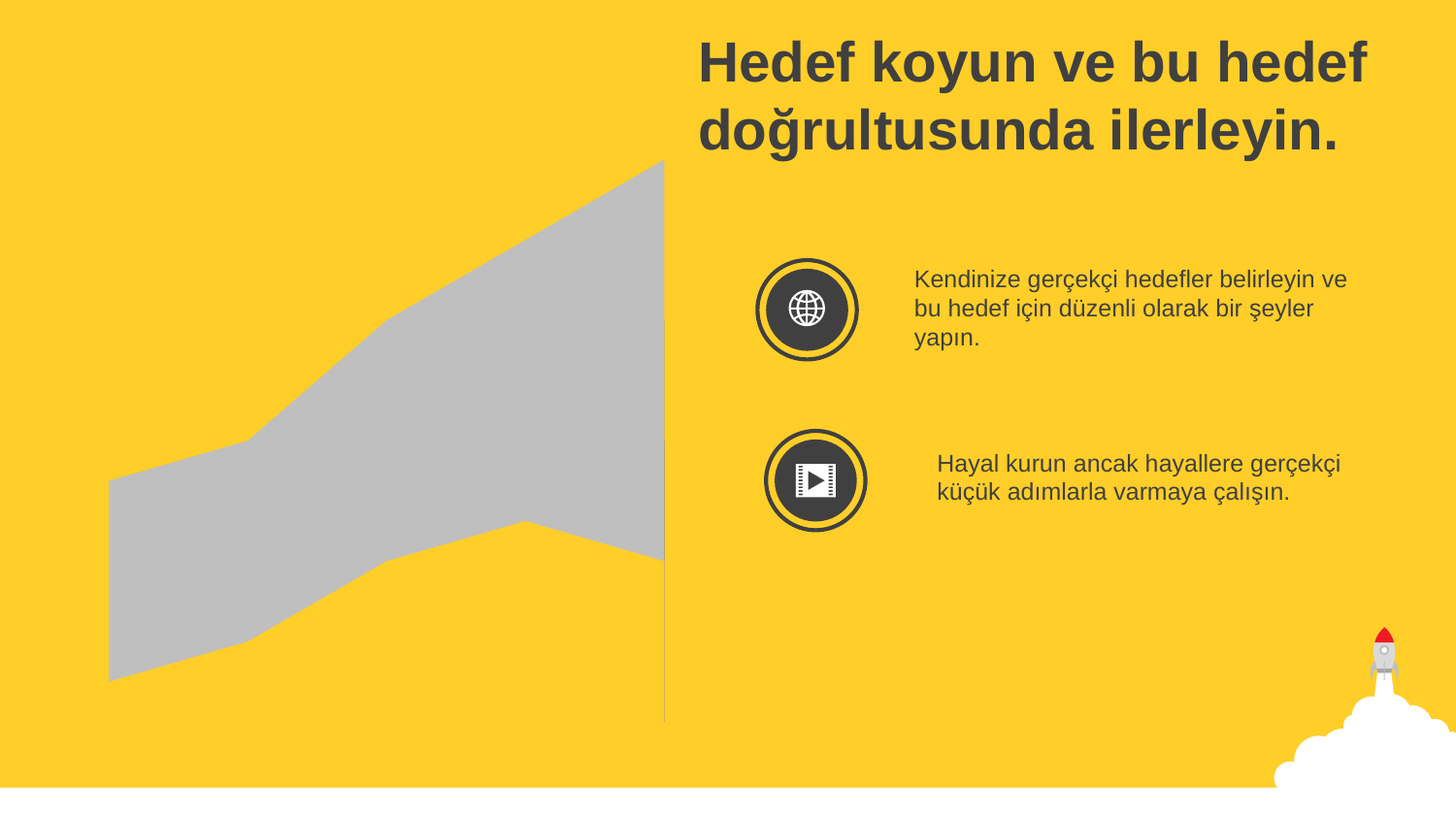
Does the chart on the left of the slide show a legend? No Does the gray area on the left-hand chart rise or fall from left to right? rise What colour is the plotted area in the chart on the left of the slide? gray What kind of chart is shown on the left side of the slide? area chart